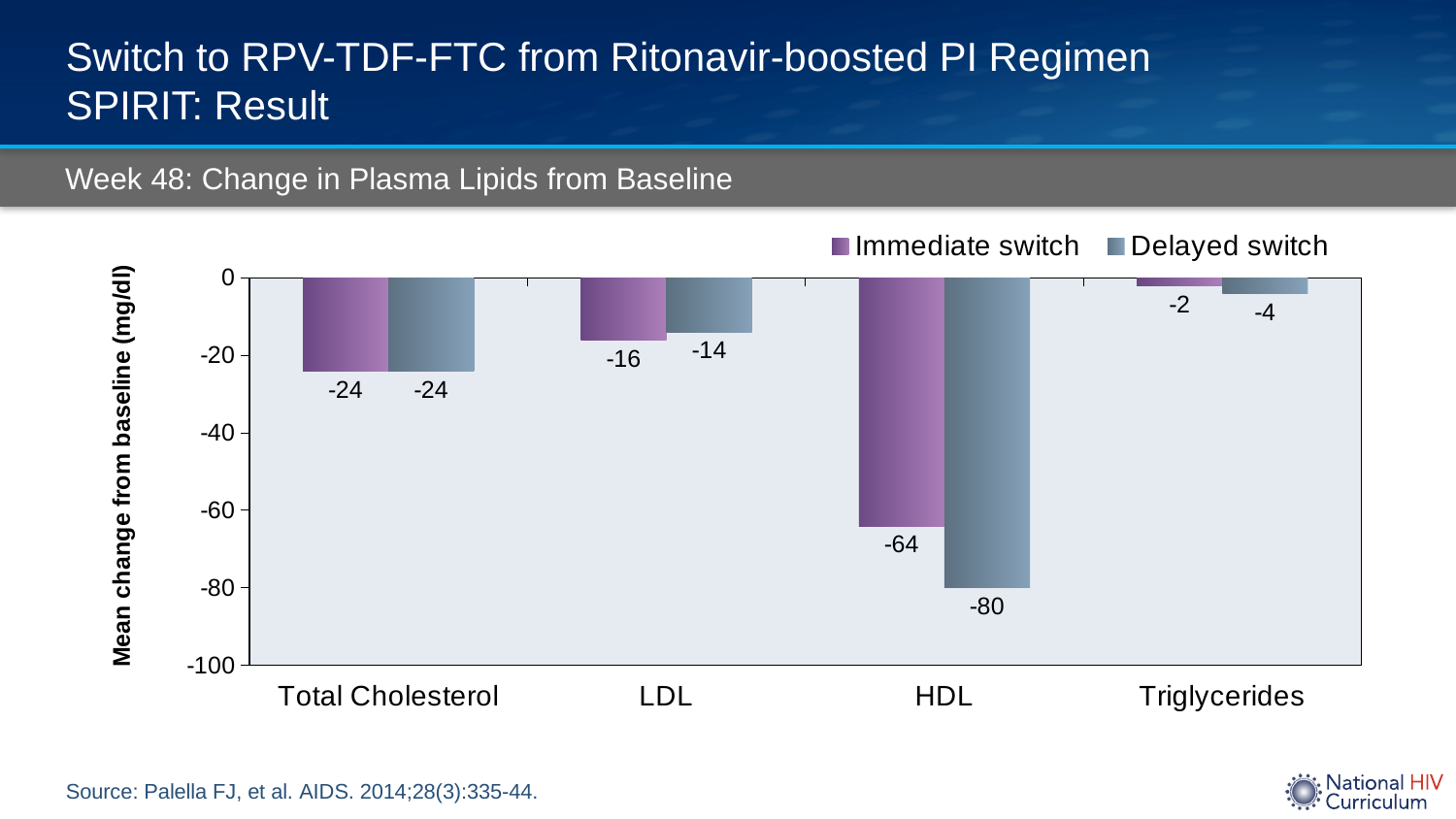
What is the value for Delayed switch for Triglycerides? -4 What is the value for Immediate switch for Total Cholesterol? -24 What kind of chart is shown on the slide? Bar chart Which category has the lowest (most negative) value for Delayed switch? HDL What is the difference between the Immediate switch and Delayed switch values for HDL? 16 How many series does the legend list? 2 For HDL, which series has the larger (less negative) value, Immediate switch or Delayed switch? Immediate switch What is the value for Delayed switch for HDL? -80 How many categories are shown on the x axis? 4 Which category has the highest (least negative) value for Immediate switch? Triglycerides What is the difference between the Immediate switch and Delayed switch values for LDL? 2 What is the value for Immediate switch for LDL? -16